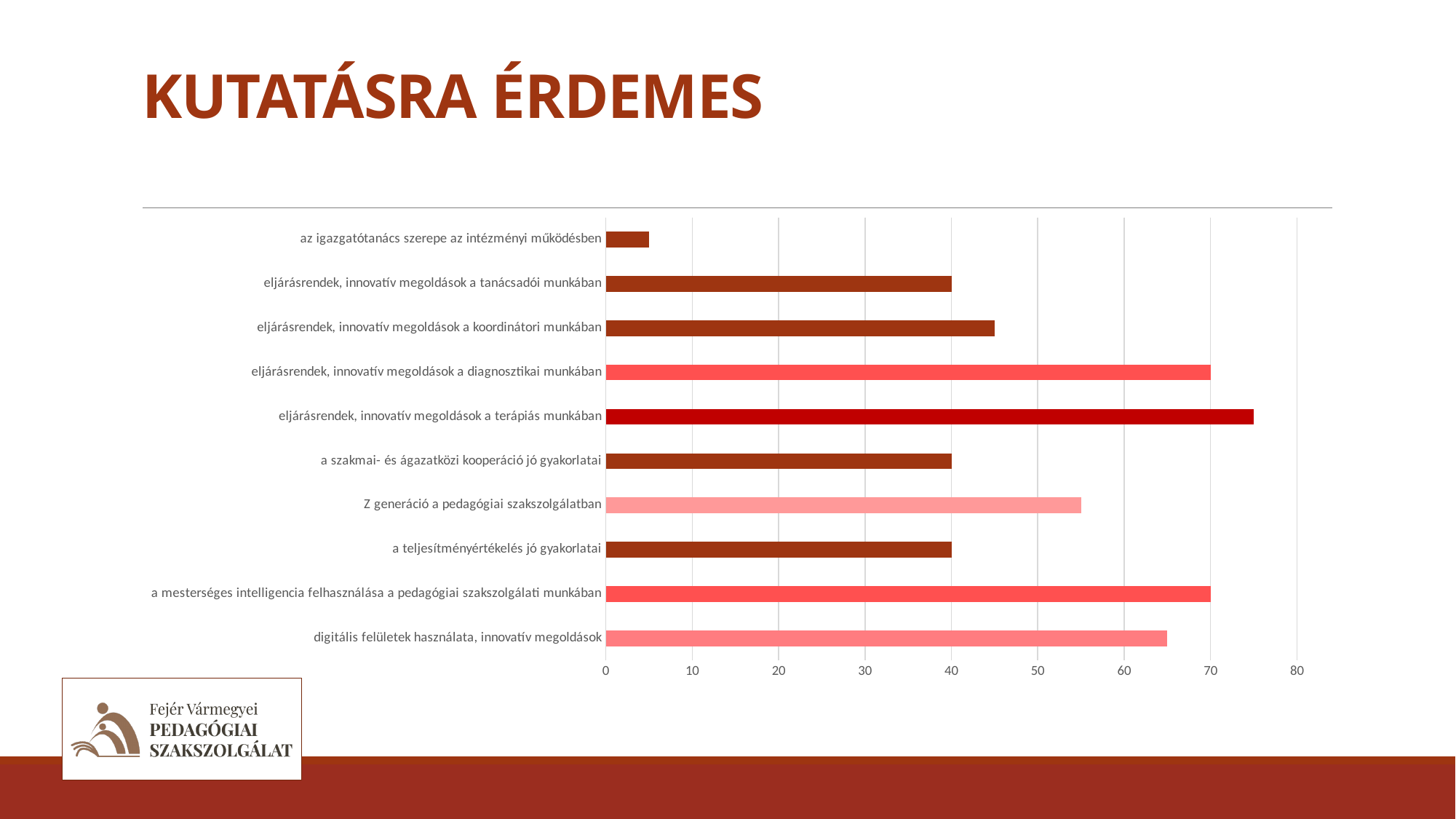
What is the value for "a mesterséges intelligencia felhasználása a pedagógiai szakszolgálati munkában"? 70 Which category has the highest value in the chart? eljárásrendek, innovatív megoldások a terápiás munkában What is the value for "a teljesítményértékelés jó gyakorlatai"? 40 Is the value for "Z generáció a pedagógiai szakszolgálatban" greater or less than 50? greater Which is larger: the value for "eljárásrendek, innovatív megoldások a koordinátori munkában" or for "eljárásrendek, innovatív megoldások a tanácsadói munkában"? eljárásrendek, innovatív megoldások a koordinátori munkában Which category has the lowest value in the chart? az igazgatótanács szerepe az intézményi működésben Is the value for "az igazgatótanács szerepe az intézményi működésben" greater or less than 10? less What is the value for "eljárásrendek, innovatív megoldások a diagnosztikai munkában"? 70 What kind of chart is shown on the slide? bar chart How many categories are plotted in the chart? 10 Is the value for "digitális felületek használata, innovatív megoldások" greater or less than 60? greater What is the difference between the values for "eljárásrendek, innovatív megoldások a diagnosztikai munkában" and "a szakmai- és ágazatközi kooperáció jó gyakorlatai"? 30